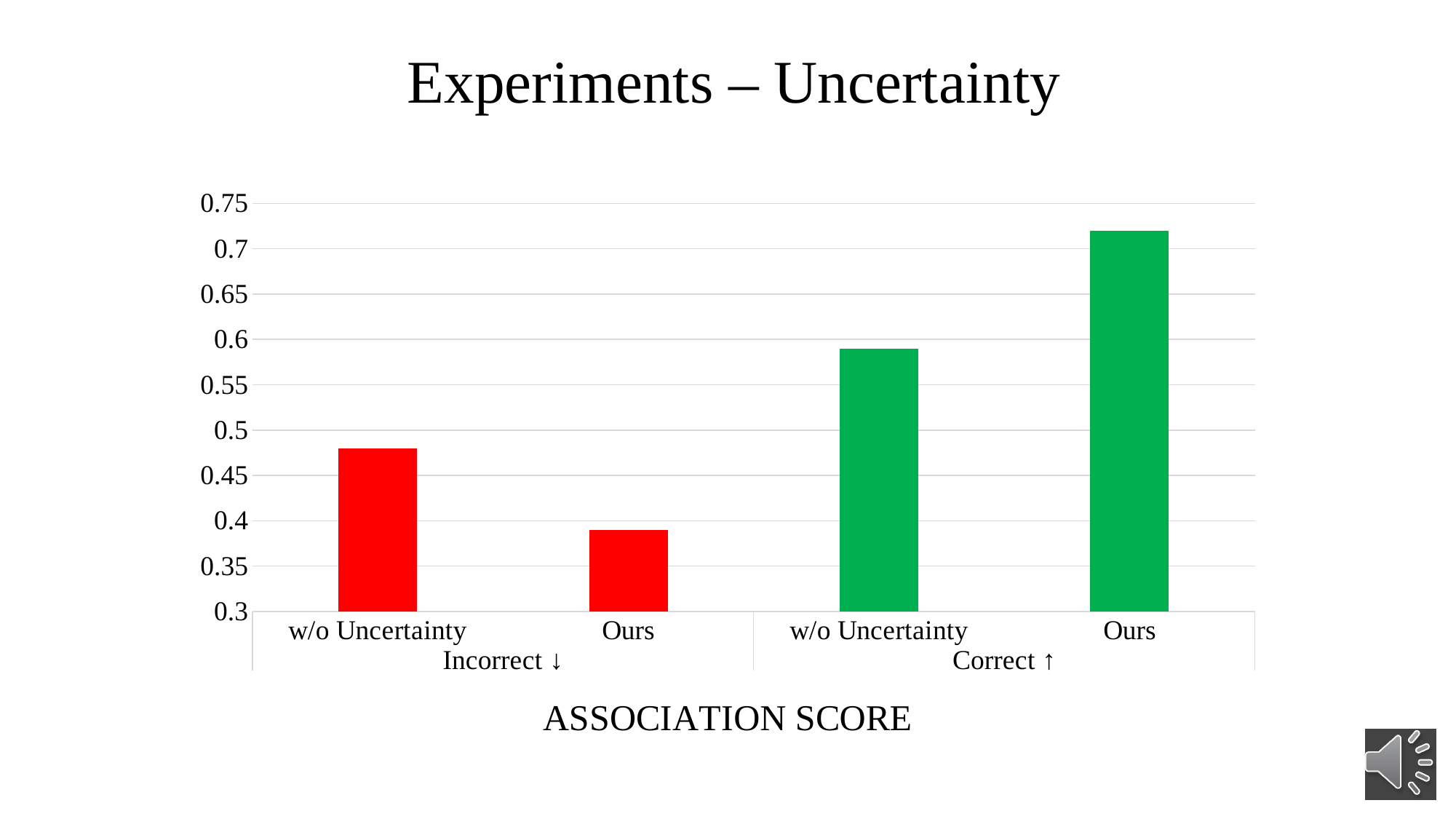
What is the title shown below the chart? ASSOCIATION SCORE What kind of chart is shown on the slide? bar chart In the Correct group, which is larger: w/o Uncertainty or Ours? Ours Is the value for w/o Uncertainty in the Correct group greater or less than 0.55? greater Is the value for Ours in the Correct group greater or less than 0.7? greater Is the value for Ours in the Incorrect group greater or less than 0.45? less What colour are the bars in the Correct group? green How many bars are plotted in the chart? 4 Which bar has the highest value in the chart? Ours (Correct) In the Incorrect group, which is larger: w/o Uncertainty or Ours? w/o Uncertainty Which bar has the lowest value in the chart? Ours (Incorrect) How many groups are shown on the x axis of the chart? 2